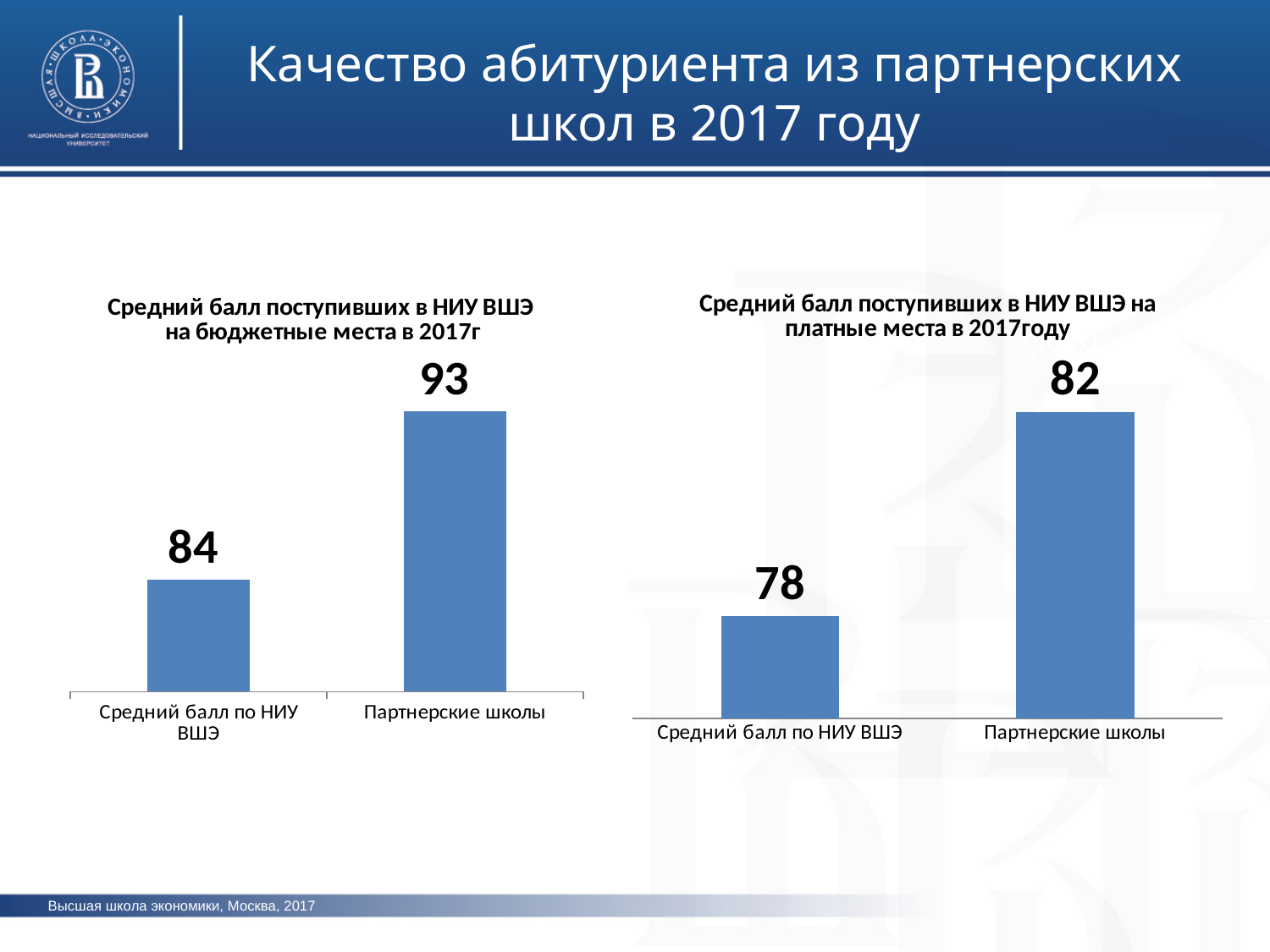
In the left chart (Средний балл поступивших в НИУ ВШЭ на бюджетные места в 2017г), what is the value for Партнерские школы? 93 What type of chart is the right chart (платные места)? Bar chart In the right chart (платные места), what is the value for Средний балл по НИУ ВШЭ? 78 In the left chart (бюджетные места), what is the value for Средний балл по НИУ ВШЭ? 84 What is the title of the left chart? Средний балл поступивших в НИУ ВШЭ на бюджетные места в 2017г In the left chart (бюджетные места), which category has the highest value? Партнерские школы In the right chart (платные места), which category has the lowest value? Средний балл по НИУ ВШЭ How many categories does the left chart (бюджетные места) show? 2 In the right chart (платные места), which is larger: Партнерские школы or Средний балл по НИУ ВШЭ? Партнерские школы In the right chart (платные места), what is the difference between Партнерские школы and Средний балл по НИУ ВШЭ? 4 In the left chart (бюджетные места), what is the difference between Партнерские школы and Средний балл по НИУ ВШЭ? 9 In the right chart (Средний балл поступивших в НИУ ВШЭ на платные места в 2017году), what is the value for Партнерские школы? 82